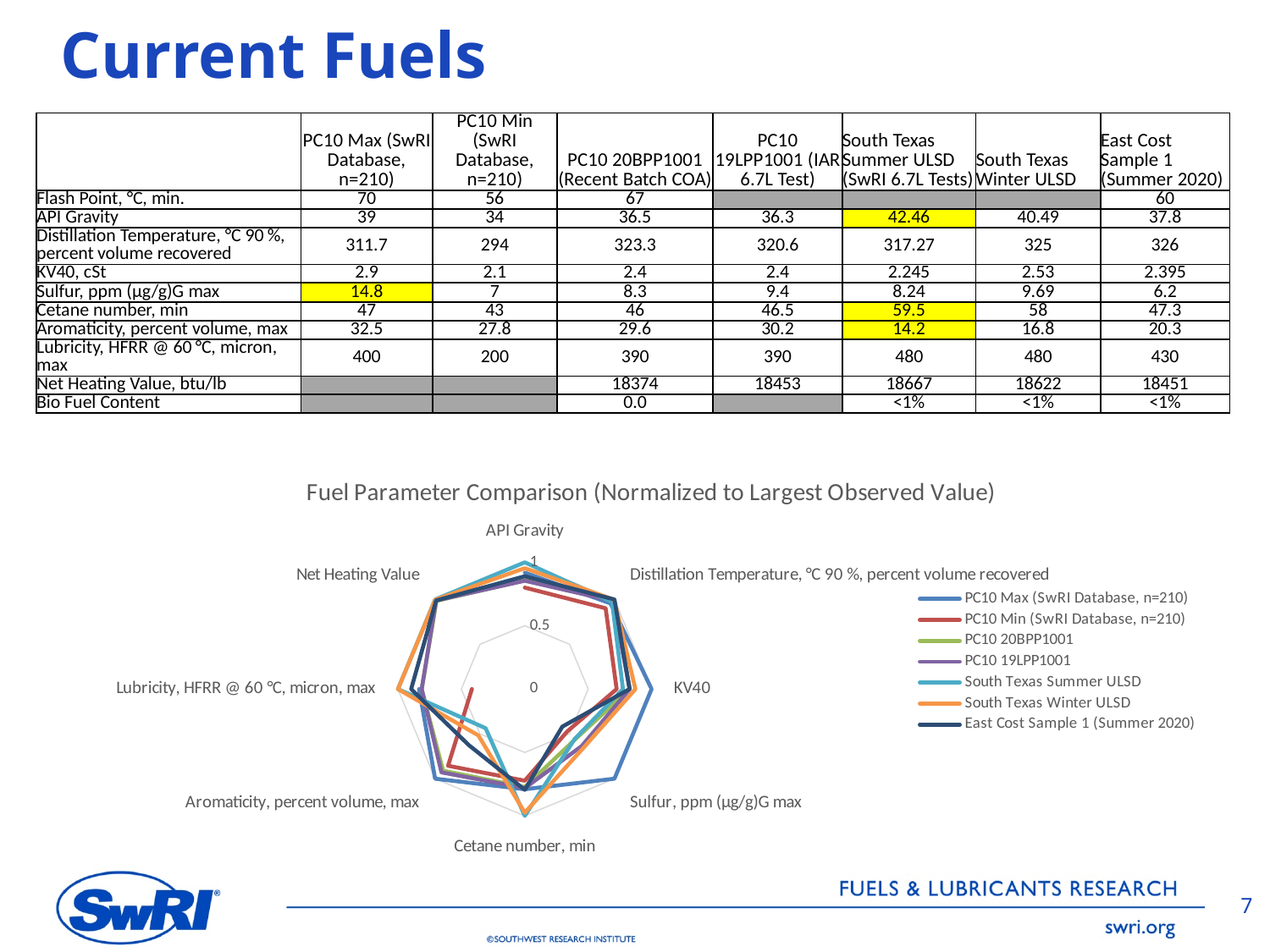
Which series has the highest normalized value on the Sulfur, ppm (µg/g)G max axis? PC10 Max (SwRI Database, n=210) Is the normalized value for PC10 Max (SwRI Database, n=210) on the Sulfur axis greater or less than 0.5? greater Is the normalized value for South Texas Summer ULSD on the Cetane number, min axis greater or less than 0.5? greater What is the largest tick value shown on the chart's radial axis? 1 How many parameter axes does the radar chart have? 8 How many series does the chart legend list? 7 Is the normalized value for PC10 Max (SwRI Database, n=210) on the API Gravity axis greater or less than 0.5? greater Which series is drawn in red on the chart? PC10 Min (SwRI Database, n=210) What kind of chart is shown on the slide? Radar chart What is the title of the chart? Fuel Parameter Comparison (Normalized to Largest Observed Value)